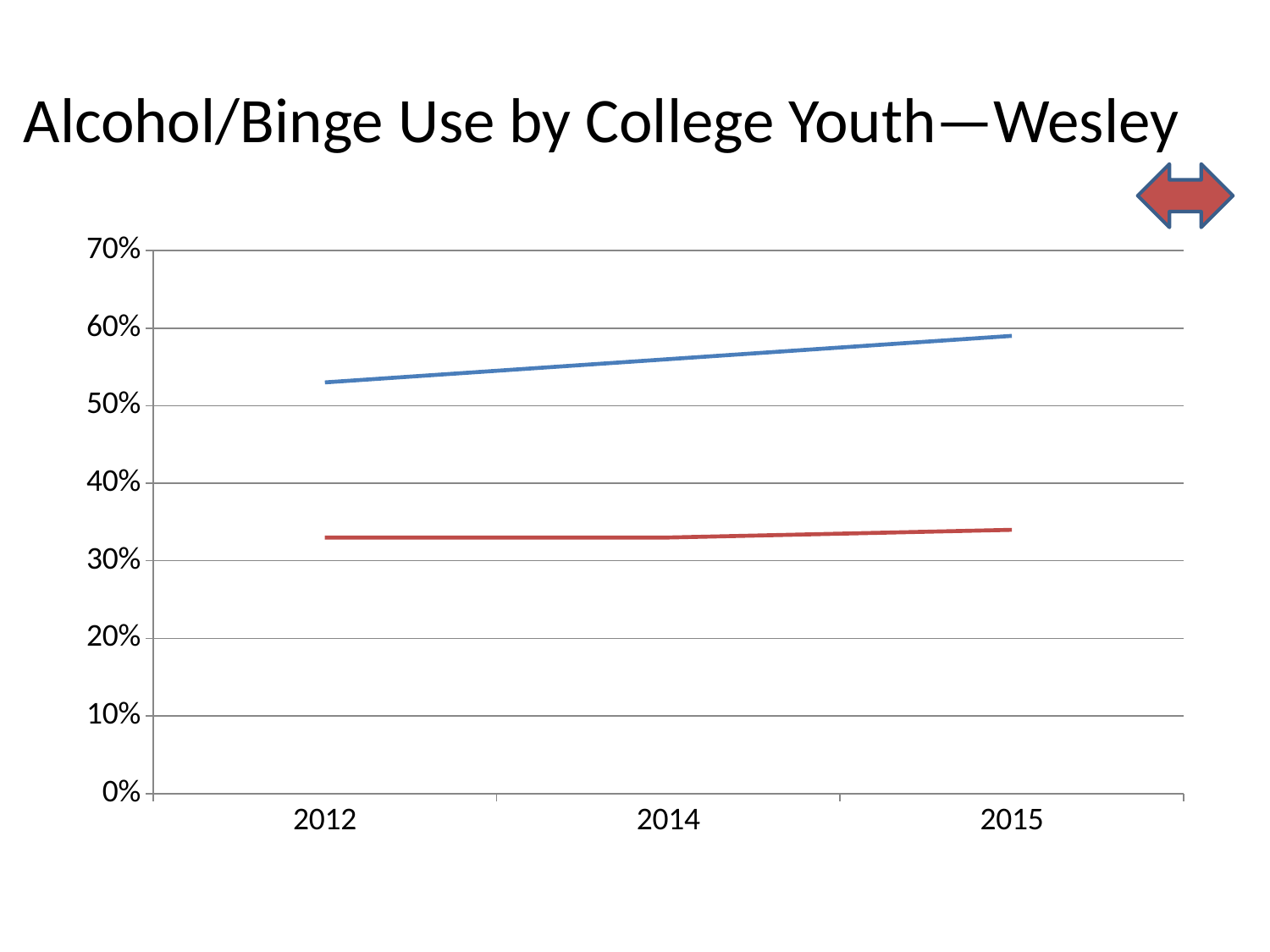
Does the blue line rise or fall from 2012 to 2015? rise Is the value of the red line in 2012 greater or less than 30%? greater Which line is higher in 2014, the blue line or the red line? blue line How many years are labelled on the x axis of the chart? 3 Is the value of the blue line in 2012 greater or less than 50%? greater What kind of chart is shown on the slide? line chart In which year does the blue line reach its highest value? 2015 What is the highest value shown on the y axis of the chart? 70% Is the value of the red line in 2015 greater or less than 40%? less How many lines are plotted on the chart? 2 What is the title of the slide? Alcohol/Binge Use by College Youth—Wesley